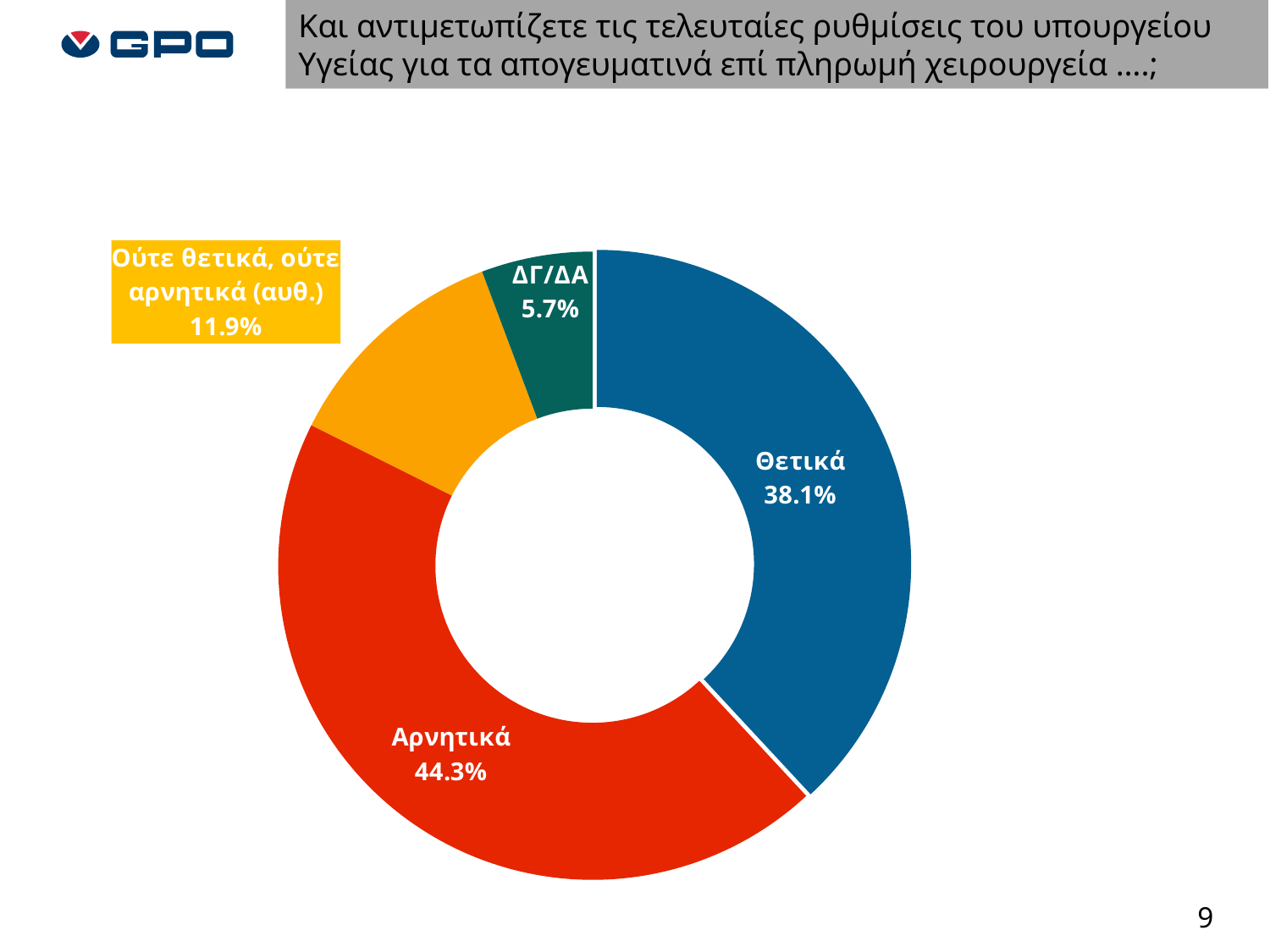
What colour is the Αρνητικά segment? Red Which category has the smallest share of the chart? ΔΓ/ΔΑ What is the difference in percentage points between Αρνητικά and Θετικά? 6.2 Which is larger, Θετικά or Ούτε θετικά, ούτε αρνητικά (αυθ.)? Θετικά What is the combined share of Θετικά and Αρνητικά? 82.4% What is the value shown for Ούτε θετικά, ούτε αρνητικά (αυθ.)? 11.9% What percentage of respondents answered Θετικά? 38.1% What kind of chart is shown on the slide? Doughnut (pie) chart What is the value shown for ΔΓ/ΔΑ? 5.7% How many categories are shown in the chart? 4 What percentage of respondents answered Αρνητικά? 44.3% Which category has the largest share of the chart? Αρνητικά